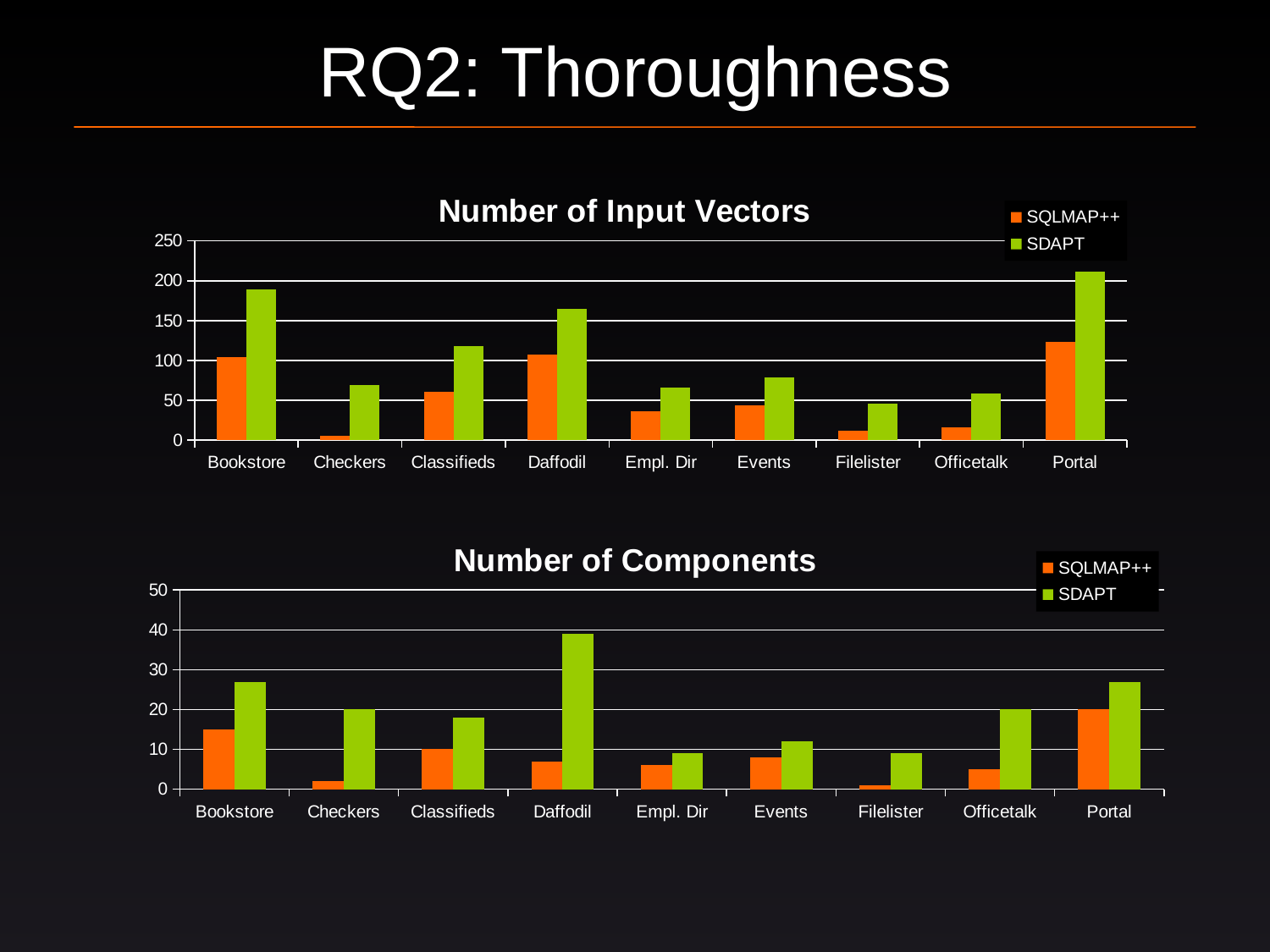
In the Number of Components chart, which category has the highest SDAPT value? Daffodil How many categories are shown on the x axis of the Number of Input Vectors chart? 9 In the Number of Input Vectors chart, is the SDAPT value for Daffodil greater or less than 150? greater What type of chart is the Number of Components chart? Bar chart In the Number of Input Vectors chart, which category has the highest SDAPT value? Portal In the Number of Input Vectors chart, which category has the lowest SQLMAP++ value? Checkers In the Number of Input Vectors chart, which is larger for Bookstore, the SQLMAP++ value or the SDAPT value? SDAPT How many series does the legend of the Number of Input Vectors chart list? 2 In the Number of Components chart, which category has the lowest SQLMAP++ value? Filelister In the Number of Components chart, is the SDAPT value for Bookstore greater or less than 20? greater What colour represents the SDAPT series in the Number of Components chart? Green In the Number of Input Vectors chart, is the SQLMAP++ value for Portal greater or less than 100? greater